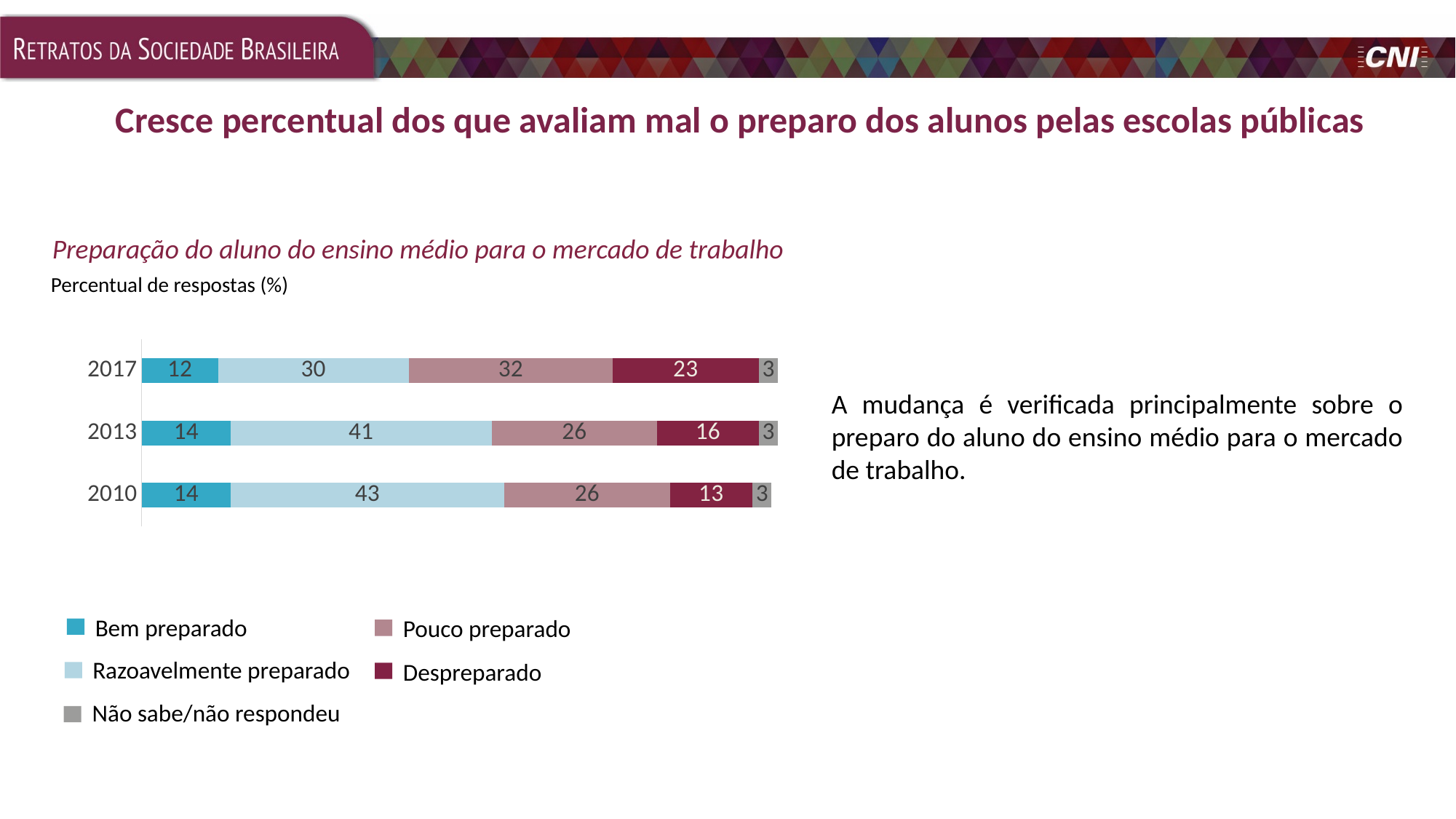
What is the value for 'Razoavelmente preparado' in 2010? 43 What is the value for 'Bem preparado' in 2017? 12 What type of chart is shown on the slide? Stacked bar chart In which year is the 'Razoavelmente preparado' value lowest? 2017 What is the total of the stacked bar for 2013? 100 How many series does the legend list? 5 How many years (categories) are shown in the chart? 3 In which year is the 'Despreparado' value highest? 2017 What is the difference between the 'Despreparado' values for 2017 and 2010? 10 Which is larger: 'Pouco preparado' in 2017 or 'Razoavelmente preparado' in 2017? Pouco preparado in 2017 What is the value for 'Despreparado' in 2017? 23 What is the value for 'Pouco preparado' in 2013? 26